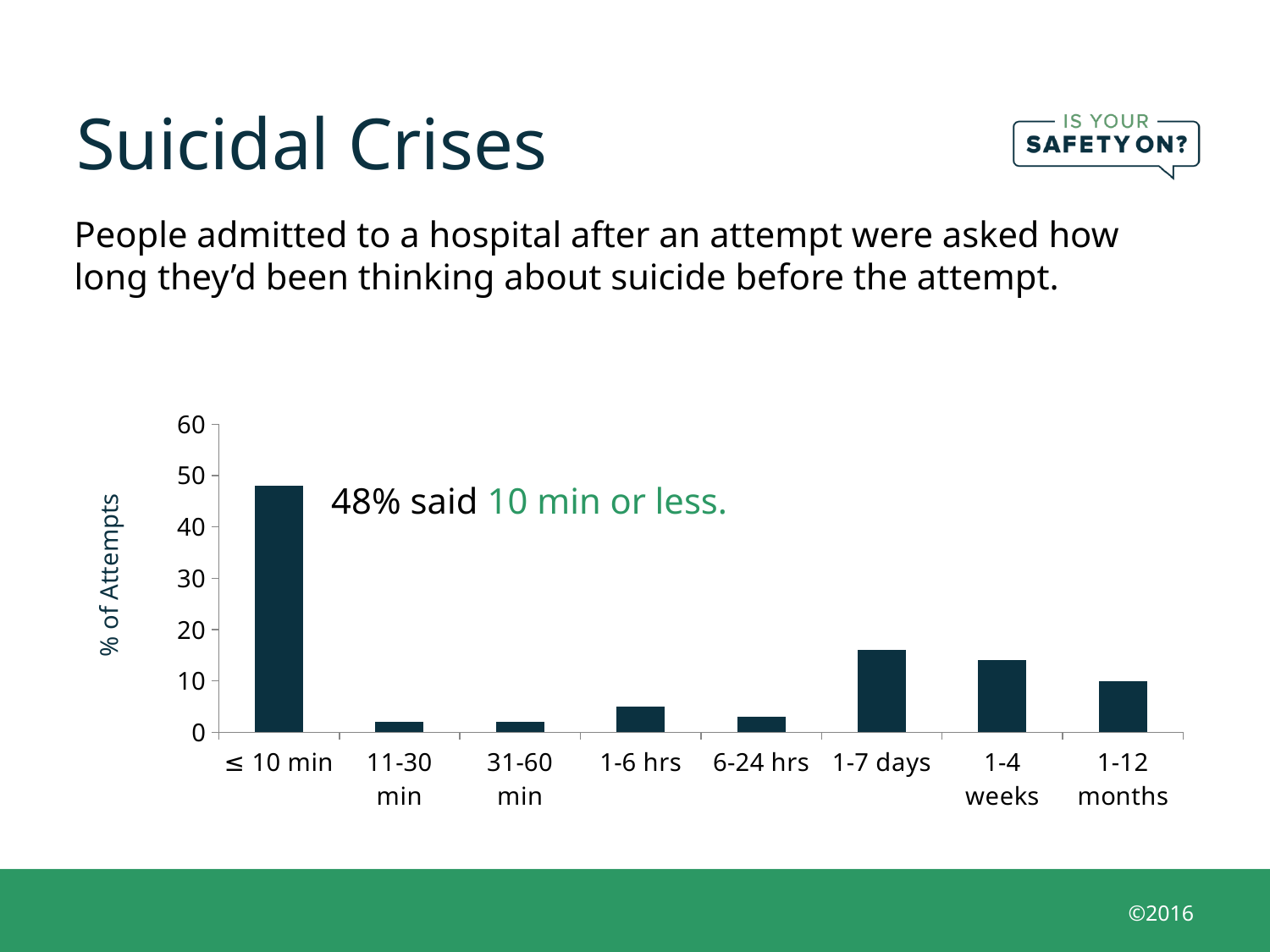
What is the label on the y axis of the chart? % of Attempts What percentage of attempts is shown for the "≤ 10 min" category? 48% Which category has the highest percentage of attempts? ≤ 10 min Is the value for "6-24 hrs" greater or less than 10? less How many categories are shown on the x axis of the chart? 8 Is the value for "1-7 days" greater or less than 10? greater Is the value for "1-4 weeks" greater or less than 10? greater Which has a higher percentage of attempts, "≤ 10 min" or "1-12 months"? ≤ 10 min What kind of chart is shown on the slide? bar chart Which has a higher percentage of attempts, "1-7 days" or "1-6 hrs"? 1-7 days